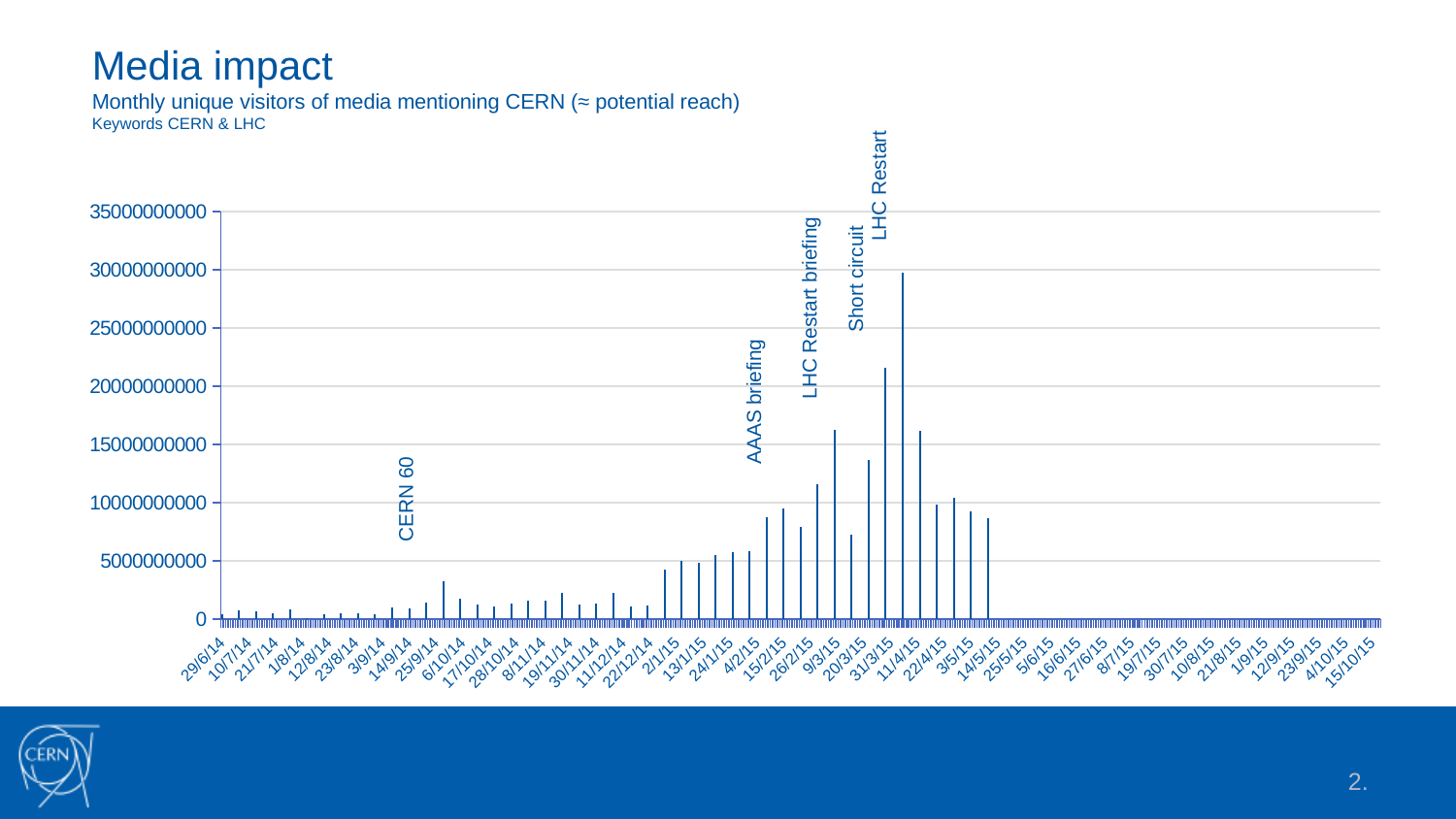
How many annotated events are labelled on the chart? 5 Is the value of the tallest bar (LHC Restart) greater or less than 25000000000? greater Is the value of the bar annotated 'LHC Restart briefing' greater or less than 10000000000? greater What is the title of the slide containing the chart? Media impact Is the value of the bar annotated 'AAAS briefing' greater or less than 10000000000? less Which annotated event corresponds to the tallest bar in the chart? LHC Restart What kind of chart is shown on the slide? bar chart Which bar is taller: the one annotated 'AAAS briefing' or the one annotated 'LHC Restart briefing'? LHC Restart briefing Which bar is taller: the one annotated 'CERN 60' or the one annotated 'LHC Restart'? LHC Restart What is the highest value shown on the y axis of the chart? 35000000000